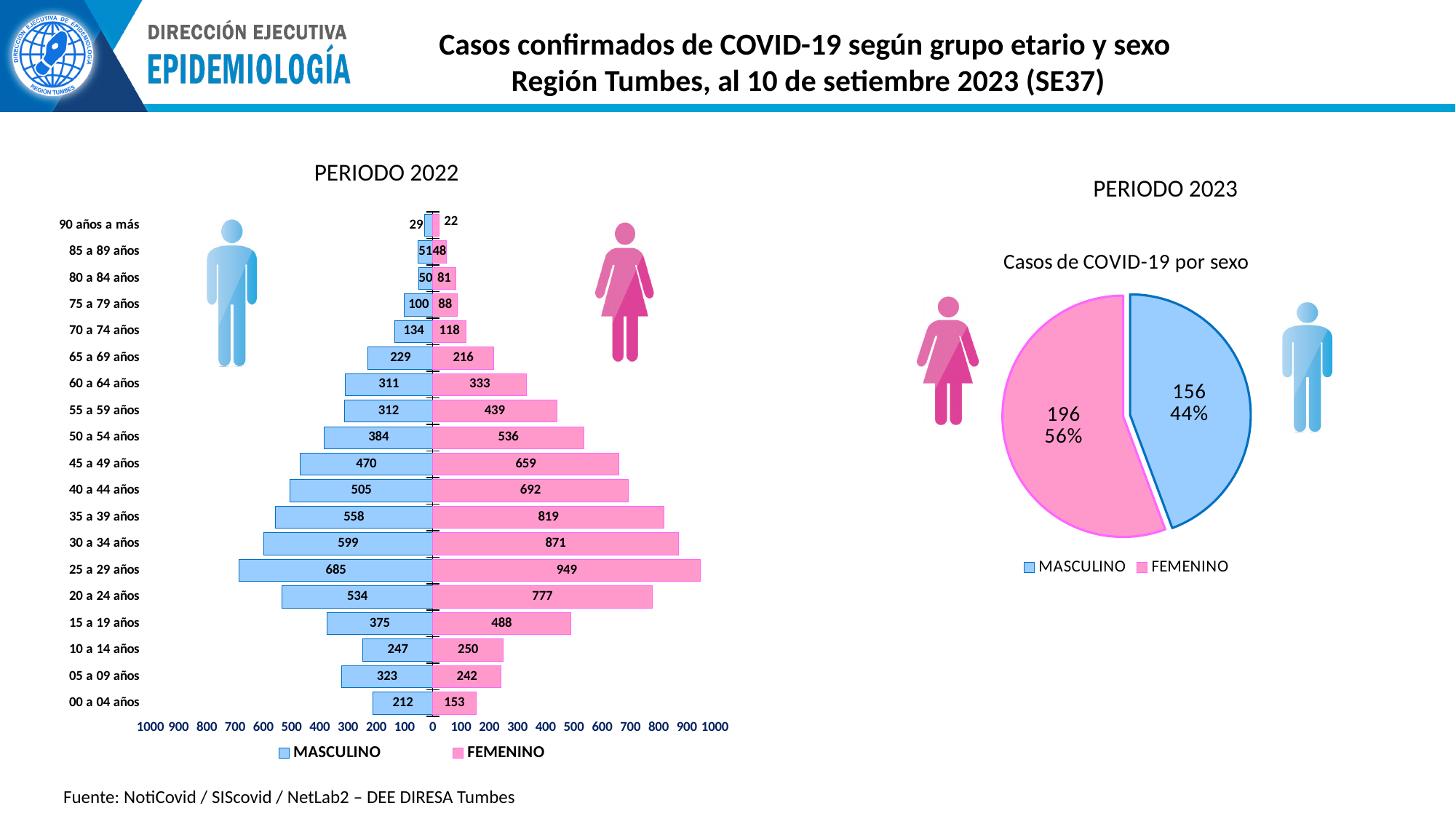
In the PERIODO 2022 chart, what is the difference between the FEMENINO and MASCULINO values for the 30 a 34 años group? 272 In the PERIODO 2022 chart, how many FEMENINO cases are shown for the 40 a 44 años group? 692 In the PERIODO 2022 chart, which age group has the highest FEMENINO value? 25 a 29 años How many age groups are shown in the PERIODO 2022 chart? 19 How many series does the legend of the PERIODO 2022 chart list? 2 In the PERIODO 2023 pie chart, how many MASCULINO cases are shown? 156 What is the title of the pie chart on the right of the slide? Casos de COVID-19 por sexo In the PERIODO 2022 chart, which age group has the lowest MASCULINO value? 90 años a más In the PERIODO 2022 chart, which is larger for the 05 a 09 años group, MASCULINO or FEMENINO? MASCULINO What kind of chart is the PERIODO 2022 chart? Bar chart In the PERIODO 2022 chart, how many MASCULINO cases are shown for the 25 a 29 años group? 685 In the PERIODO 2023 pie chart, what share of cases is FEMENINO? 56%